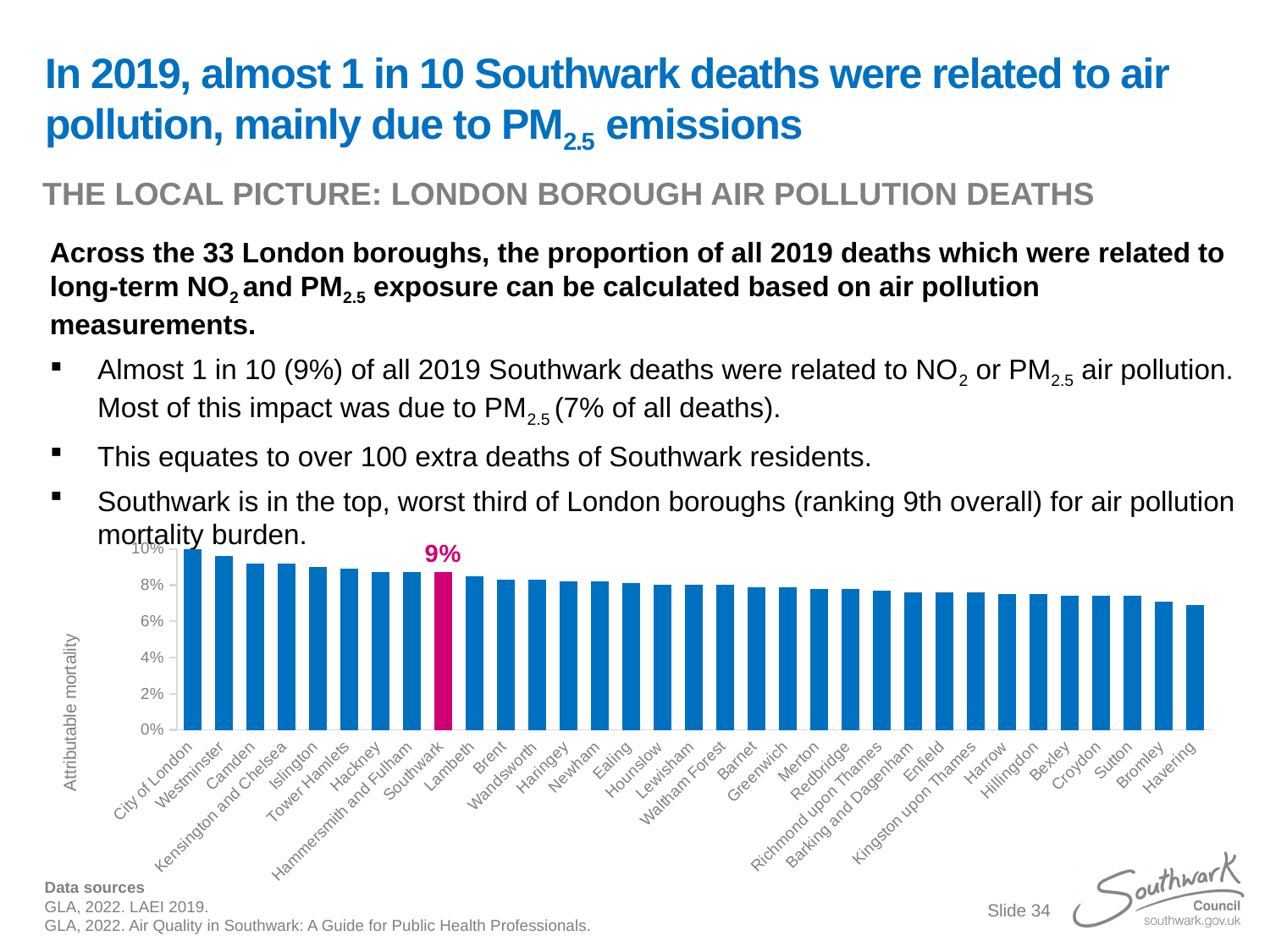
Is the value for Havering greater or less than 8%? less What is the label on the vertical axis of the chart? Attributable mortality Which borough has the lowest attributable mortality in the chart? Havering Which borough has the highest attributable mortality in the chart? City of London How many boroughs are shown as bars in the chart? 33 Is the value for City of London greater or less than 8%? greater What is the attributable mortality value labelled for Southwark? 9% What kind of chart is shown on the slide? Bar chart Which has the larger attributable mortality, City of London or Havering? City of London Is the value for Westminster greater or less than 8%? greater Do the bar values rise or fall from left to right across the chart? Fall